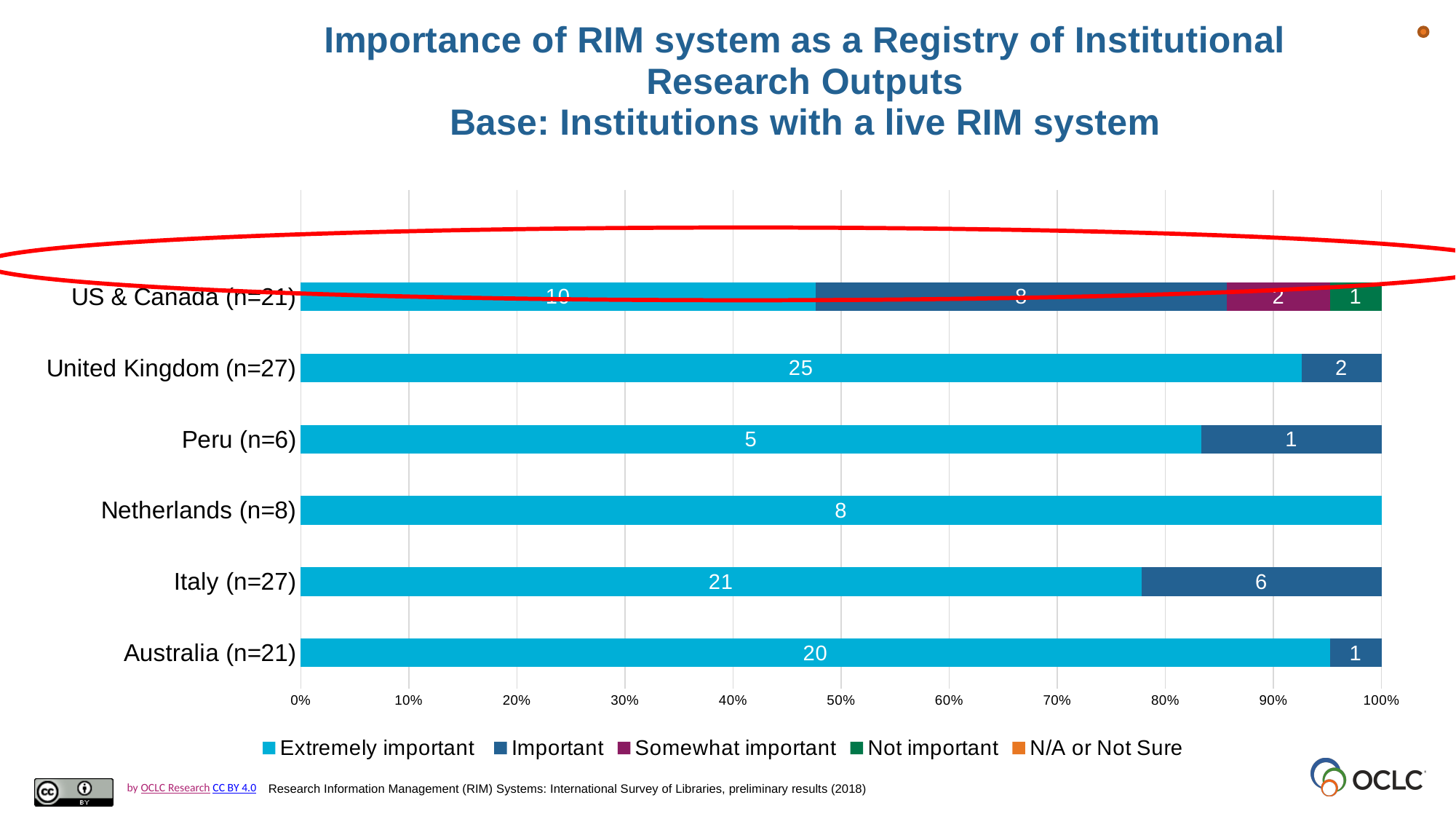
How many series does the legend list? 5 How many country/region categories are plotted on the chart? 6 What kind of chart is shown on the slide? stacked bar chart What is the value for Important for Peru (n=6)? 1 What is the value for Extremely important for United Kingdom (n=27)? 25 Is the Extremely important share of the bar for Italy (n=27) greater or less than 70%? greater What is the value for Extremely important for Australia (n=21)? 20 Which category has the highest Extremely important value? United Kingdom (n=27) What is the value for Not important for US & Canada (n=21)? 1 Which is larger, the Important value for Italy (n=27) or for United Kingdom (n=27)? Italy (n=27) What is the value for Important for Italy (n=27)? 6 What is the difference between the Extremely important values for Italy (n=27) and Australia (n=21)? 1